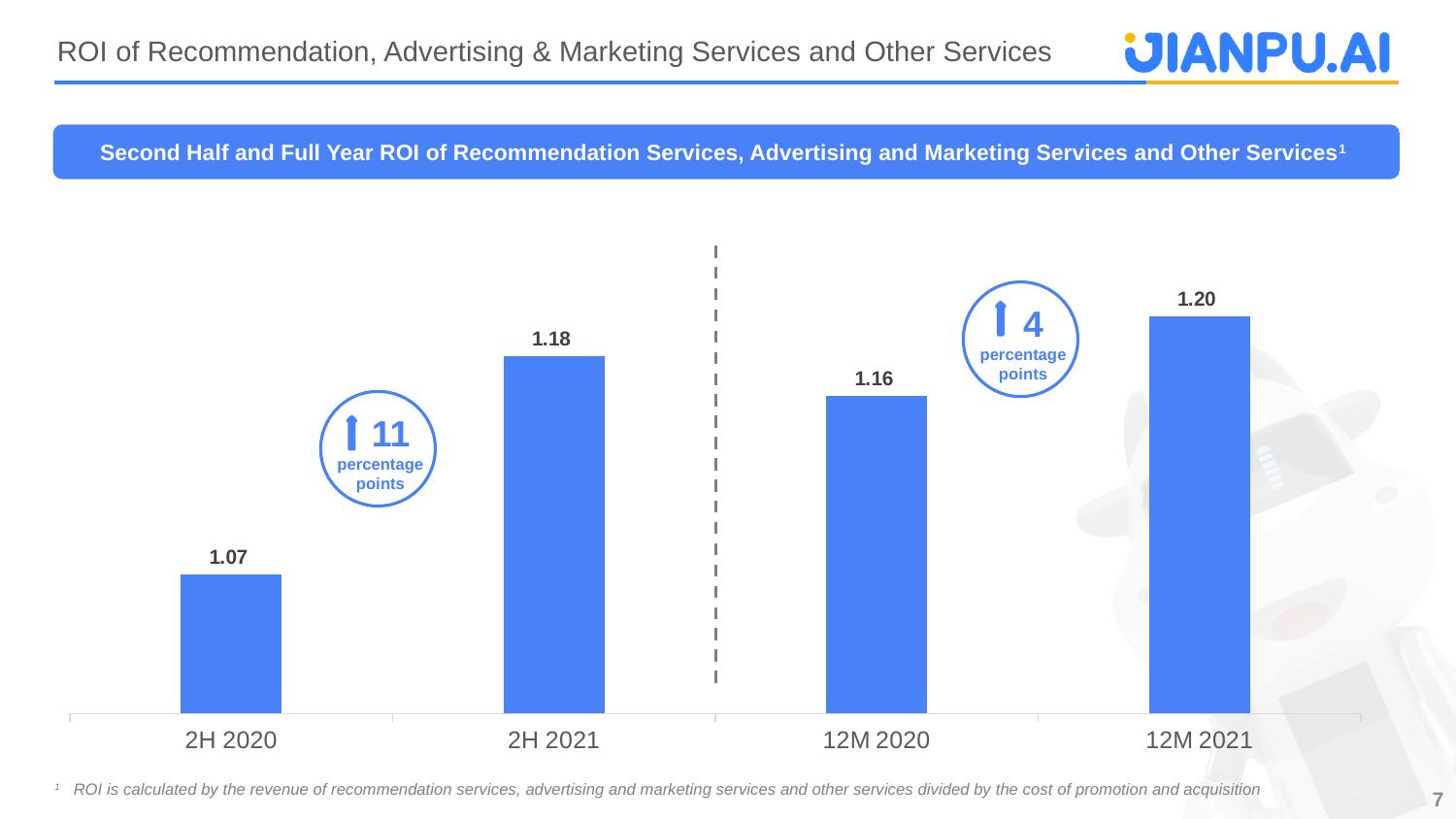
Which period has the lowest ROI? 2H 2020 What is the ROI value for 12M 2020? 1.16 What is the ROI value for 12M 2021? 1.20 What is the ROI value for 2H 2021? 1.18 What is the difference between the ROI for 2H 2021 and 2H 2020? 0.11 What is the ROI value for 2H 2020? 1.07 Which period has the highest ROI? 12M 2021 Which is larger, the ROI for 2H 2021 or the ROI for 12M 2020? 2H 2021 How many periods are shown on the chart? 4 What is the difference between the ROI for 12M 2021 and 12M 2020? 0.04 What kind of chart is shown on the slide? Bar chart According to the callout, by how many percentage points did ROI increase from 12M 2020 to 12M 2021? 4 percentage points